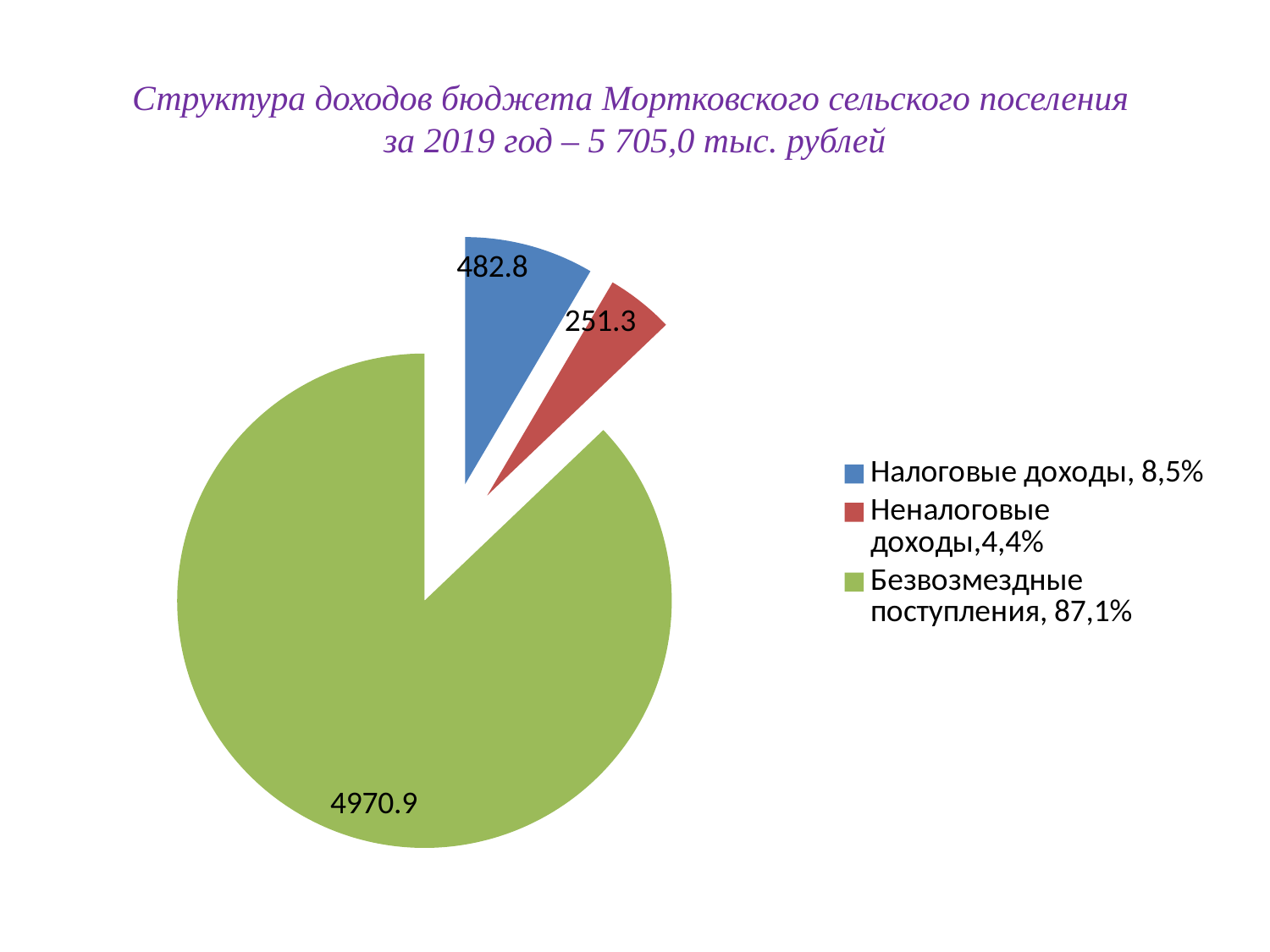
What is the value shown for Неналоговые доходы? 251.3 Which category has the smallest slice of the pie? Неналоговые доходы Which is larger, the value for Налоговые доходы or the value for Неналоговые доходы? Налоговые доходы What is the difference between the values for Налоговые доходы and Неналоговые доходы? 231.5 How many slices does the pie chart have? 3 Which category has the largest slice of the pie? Безвозмездные поступления What share of the pie does Налоговые доходы represent, according to the legend? 8,5% What share of the pie does Безвозмездные поступления represent, according to the legend? 87,1% What is the value shown for Безвозмездные поступления? 4970.9 What is the value shown for Налоговые доходы? 482.8 What colour is the slice for Неналоговые доходы? Red What kind of chart is shown on the slide? Pie chart